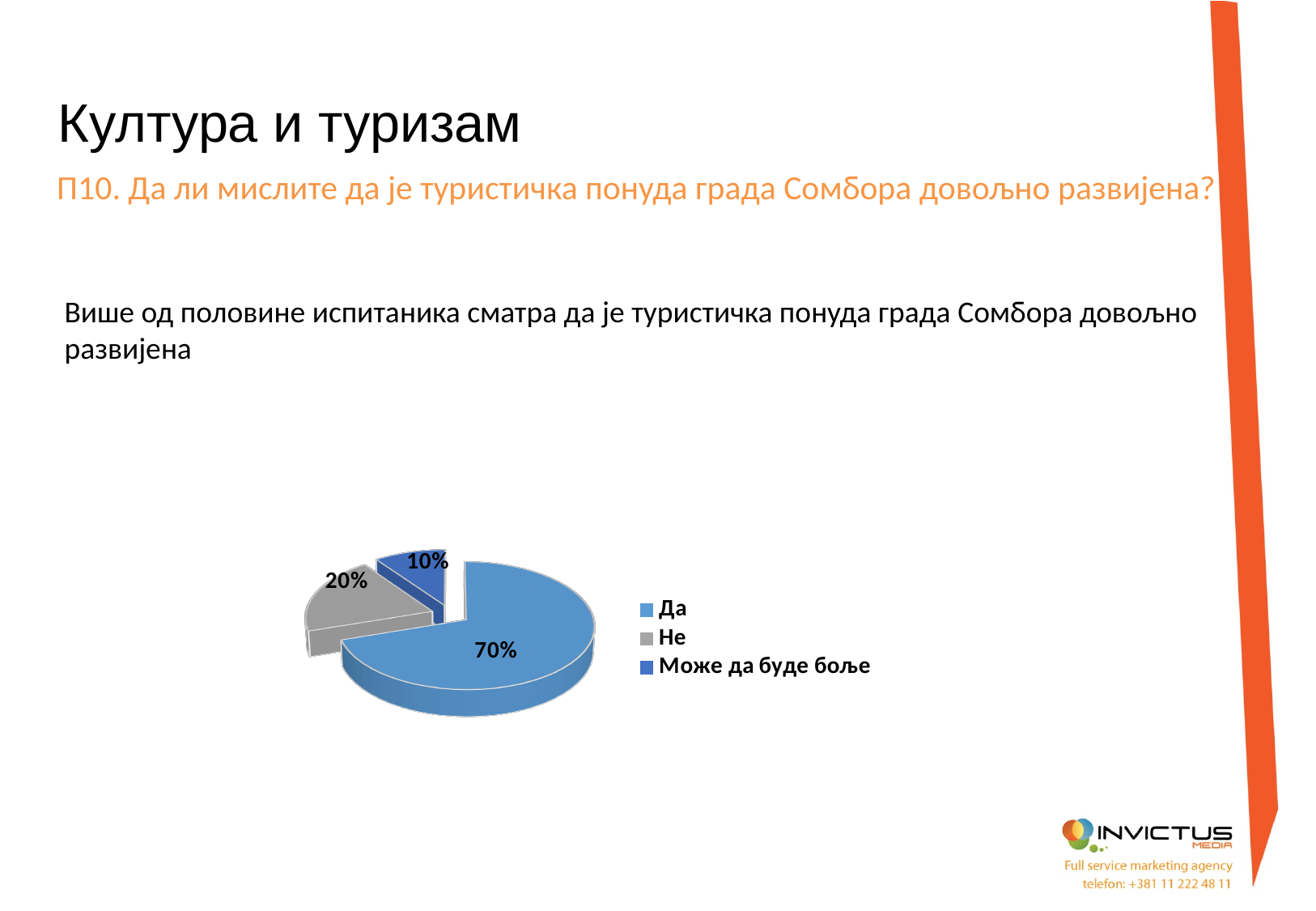
Which answer has the largest slice of the pie? Да What kind of chart is shown on the slide? pie chart What is the difference in percentage points between the "Не" and "Може да буде боље" slices? 10 How many slices does the pie chart have? 3 What share of respondents answered "Не"? 20% What share of respondents answered "Може да буде боље"? 10% Which slice is larger, "Не" or "Може да буде боље"? Не Which answer has the smallest slice of the pie? Може да буде боље How many entries does the legend list? 3 What share of respondents answered "Да"? 70% What is the difference in percentage points between the "Да" and "Не" slices? 50 What colour is the "Не" slice in the pie chart? grey